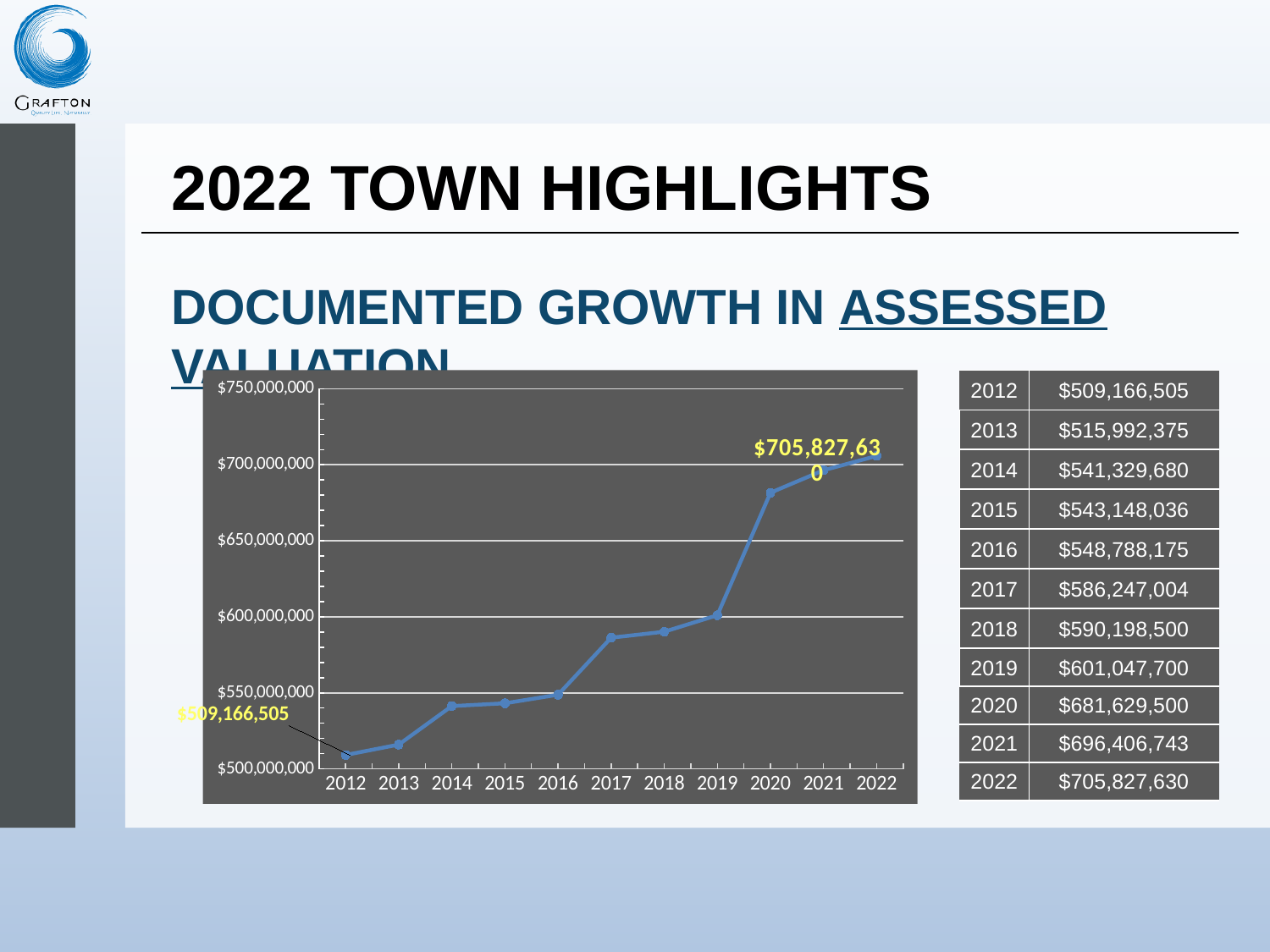
What is the assessed valuation for 2022 according to the data label on the chart? $705,827,630 What is the assessed valuation for 2018 as listed in the table beside the chart? $590,198,500 How many years are plotted on the x axis of the chart? 11 What is the difference between the 2022 and 2012 assessed valuations shown on the chart's data labels? $196,661,125 Which year has the highest assessed valuation on the chart? 2022 Is the value for 2017 greater or less than $600,000,000? less What type of chart is shown on the slide? line chart Which year has the lowest assessed valuation on the chart? 2012 Do the values on the chart generally rise or fall from 2012 to 2022? rise Is the value for 2020 greater or less than $650,000,000? greater What is the assessed valuation for 2012 according to the data label on the chart? $509,166,505 Which year has the larger assessed valuation, 2019 or 2020? 2020